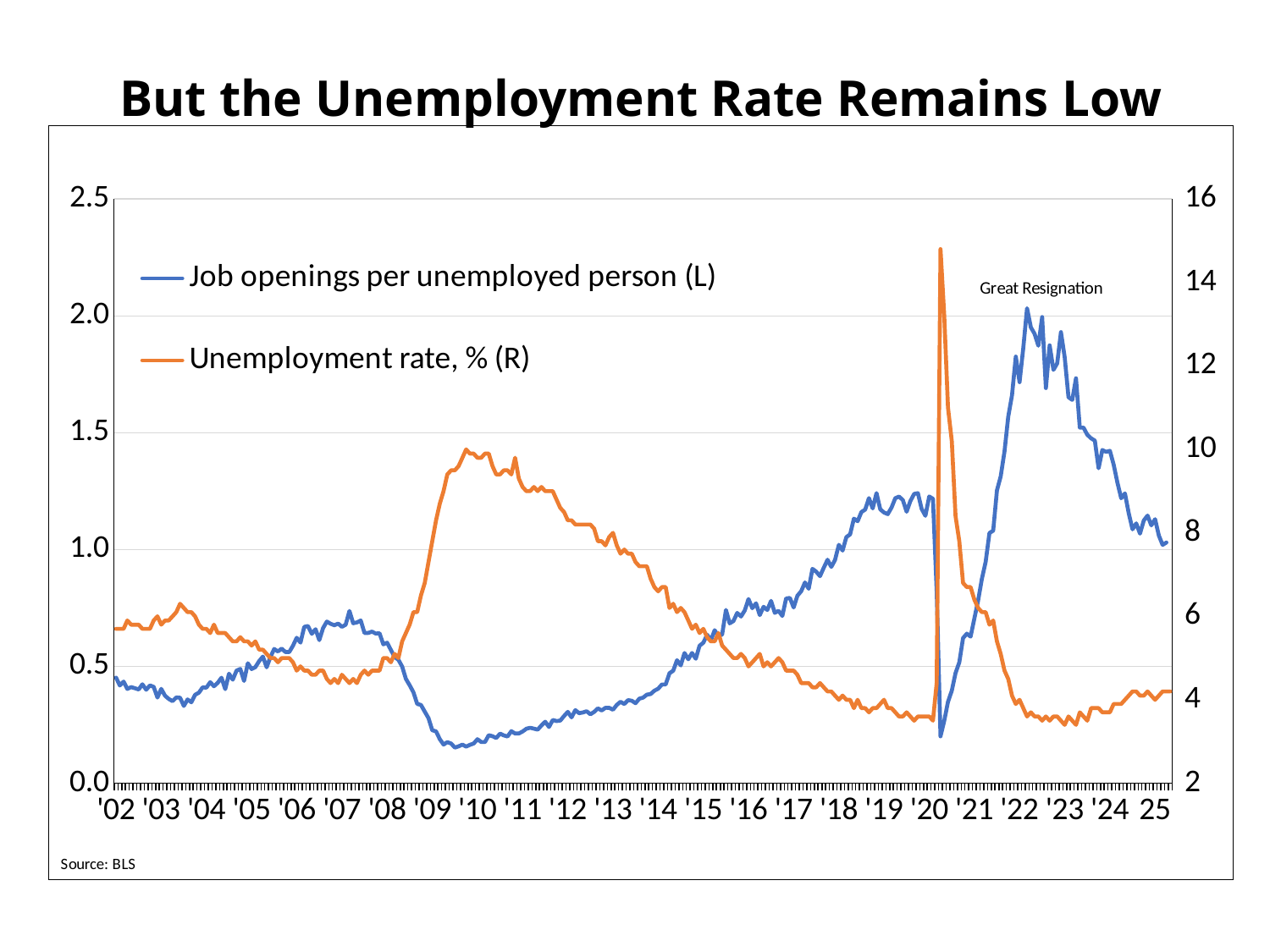
Is the peak value of job openings per unemployed person in 2022 greater or less than 1.5? greater Does the job openings per unemployed person series rise or fall from 2022 to 2025? fall Which series is plotted in orange? Unemployment rate, % (R) How many series does the legend list? 2 Is the unemployment rate in 2010 greater or less than 8? greater In which year does the unemployment rate reach its highest point? 2020 Does the unemployment rate rise or fall from 2010 to 2019? fall In which year does the job openings per unemployed person series reach its highest point? 2022 What kind of chart is shown on the slide? Line chart Is the value of job openings per unemployed person in 2010 greater or less than 0.5? less What is the title of the slide's chart? But the Unemployment Rate Remains Low